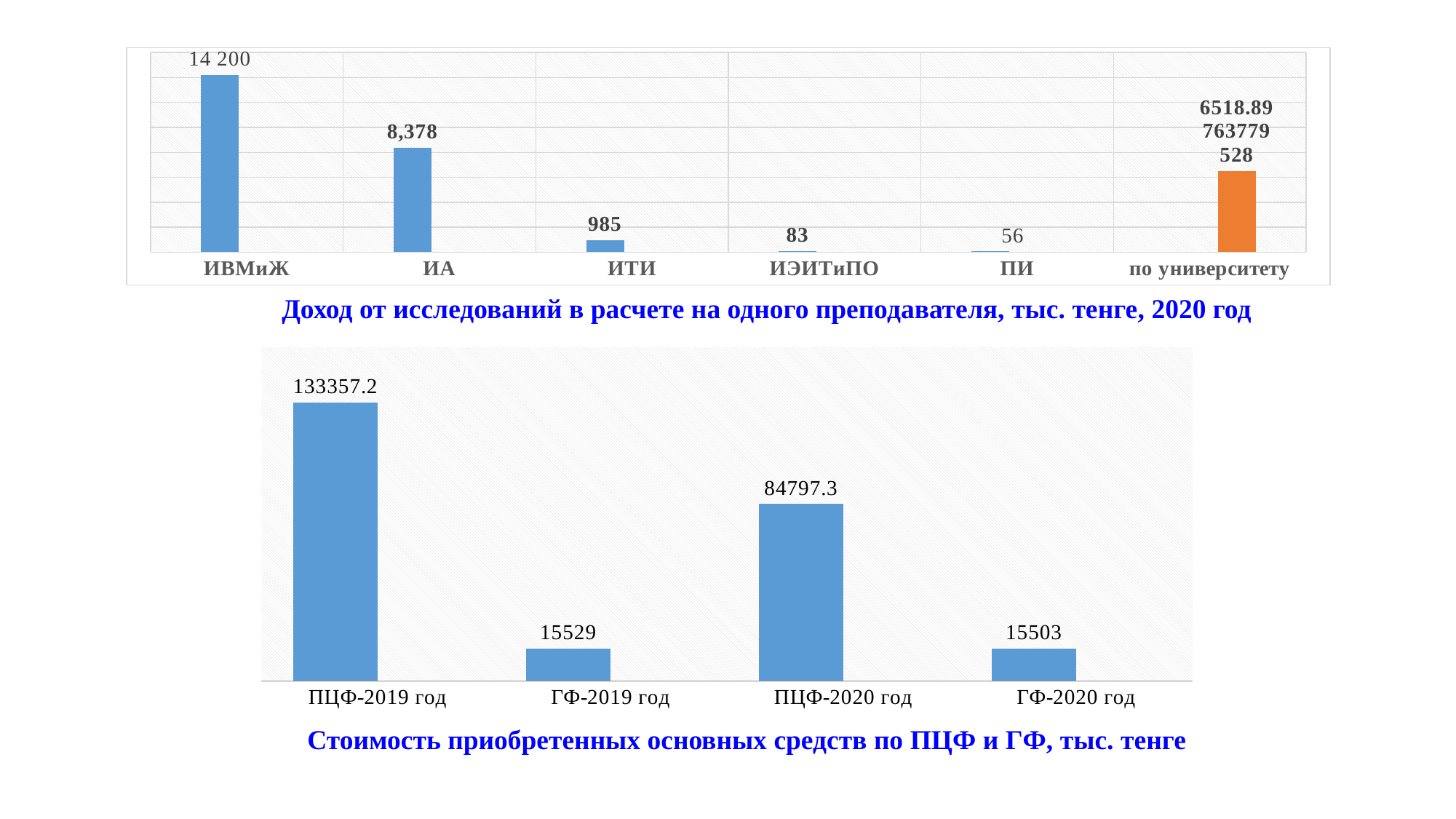
In the top chart (Доход от исследований в расчете на одного преподавателя), which category has the lowest value? ПИ In the top chart (Доход от исследований в расчете на одного преподавателя), which category has the highest value? ИВМиЖ In the top chart (Доход от исследований в расчете на одного преподавателя), what is the value for ИТИ? 985 In the bottom chart (Стоимость приобретенных основных средств по ПЦФ и ГФ), what is the value for ПЦФ-2020 год? 84797.3 In the top chart (Доход от исследований в расчете на одного преподавателя), what is the difference between the values for ИТИ and ИЭИТиПО? 902 In the top chart (Доход от исследований в расчете на одного преподавателя), what is the value for ИВМиЖ? 14 200 In the bottom chart (Стоимость приобретенных основных средств по ПЦФ и ГФ), what is the difference between the values for ПЦФ-2019 год and ПЦФ-2020 год? 48559.9 What type of chart is the bottom chart (Стоимость приобретенных основных средств по ПЦФ и ГФ)? Bar chart In the top chart (Доход от исследований в расчете на одного преподавателя), what is the value for ИА? 8,378 In the top chart (Доход от исследований в расчете на одного преподавателя), how many categories are shown on the x axis? 6 In the bottom chart (Стоимость приобретенных основных средств по ПЦФ и ГФ), which category has the highest value? ПЦФ-2019 год In the bottom chart (Стоимость приобретенных основных средств по ПЦФ и ГФ), what is the value for ГФ-2019 год? 15529